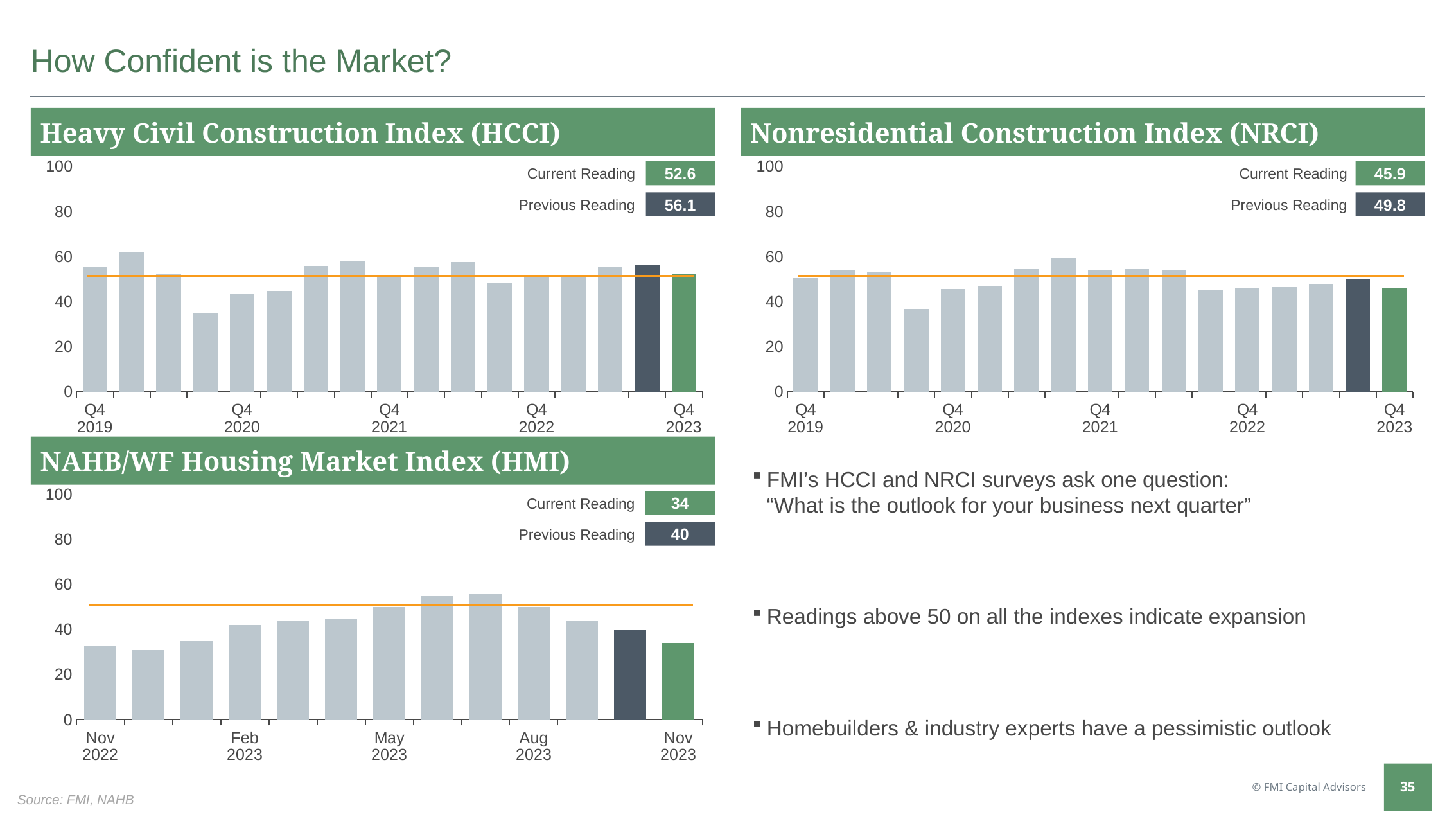
In the NAHB/WF Housing Market Index (HMI) chart, by how much did the Current Reading fall from the Previous Reading? 6 In the Nonresidential Construction Index (NRCI) chart, what is the Previous Reading? 49.8 In the Nonresidential Construction Index (NRCI) chart, what is the Current Reading? 45.9 How many bars are plotted in the NAHB/WF Housing Market Index (HMI) chart? 13 In the NAHB/WF Housing Market Index (HMI) chart, what is the Current Reading? 34 In the Heavy Civil Construction Index (HCCI) chart, what is the Current Reading? 52.6 Which is larger, the Current Reading in the HCCI chart or the Current Reading in the NRCI chart? HCCI What type of chart is the NAHB/WF Housing Market Index (HMI) chart? bar chart In the NAHB/WF Housing Market Index (HMI) chart, do the values rise or fall from Aug 2023 to Nov 2023? fall In the Heavy Civil Construction Index (HCCI) chart, what is the Previous Reading? 56.1 In the Heavy Civil Construction Index (HCCI) chart, what is the difference between the Previous Reading and the Current Reading? 3.5 In the NAHB/WF Housing Market Index (HMI) chart, is the value for Nov 2022 greater or less than 40? less